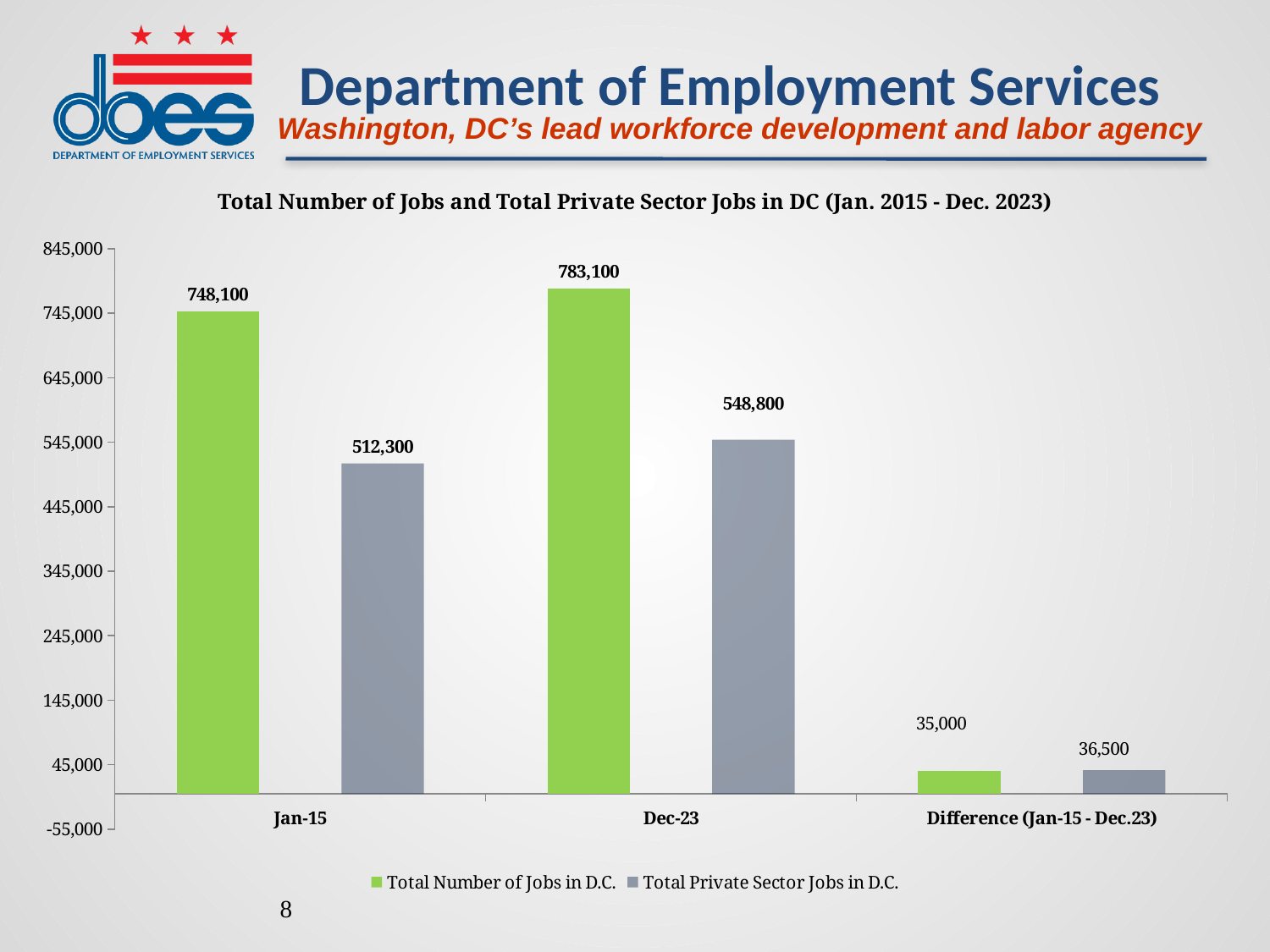
How many series does the legend list? 2 What colour represents Total Number of Jobs in D.C. in the chart? Green What is the Total Private Sector Jobs in D.C. value for Dec-23? 548,800 Which category has the highest Total Number of Jobs in D.C.? Dec-23 What is the Total Number of Jobs in D.C. for Jan-15? 748,100 What is the Total Number of Jobs in D.C. value shown for the Difference (Jan-15 - Dec.23) category? 35,000 What is the Total Private Sector Jobs in D.C. value for Jan-15? 512,300 How many categories are shown on the x axis? 3 Which is larger for the Difference (Jan-15 - Dec.23) category: Total Number of Jobs in D.C. or Total Private Sector Jobs in D.C.? Total Private Sector Jobs in D.C. Which category has the lowest Total Private Sector Jobs in D.C. value? Difference (Jan-15 - Dec.23) What kind of chart is shown on the slide? Bar chart What is the difference between the Total Number of Jobs in D.C. and the Total Private Sector Jobs in D.C. for Dec-23? 234,300